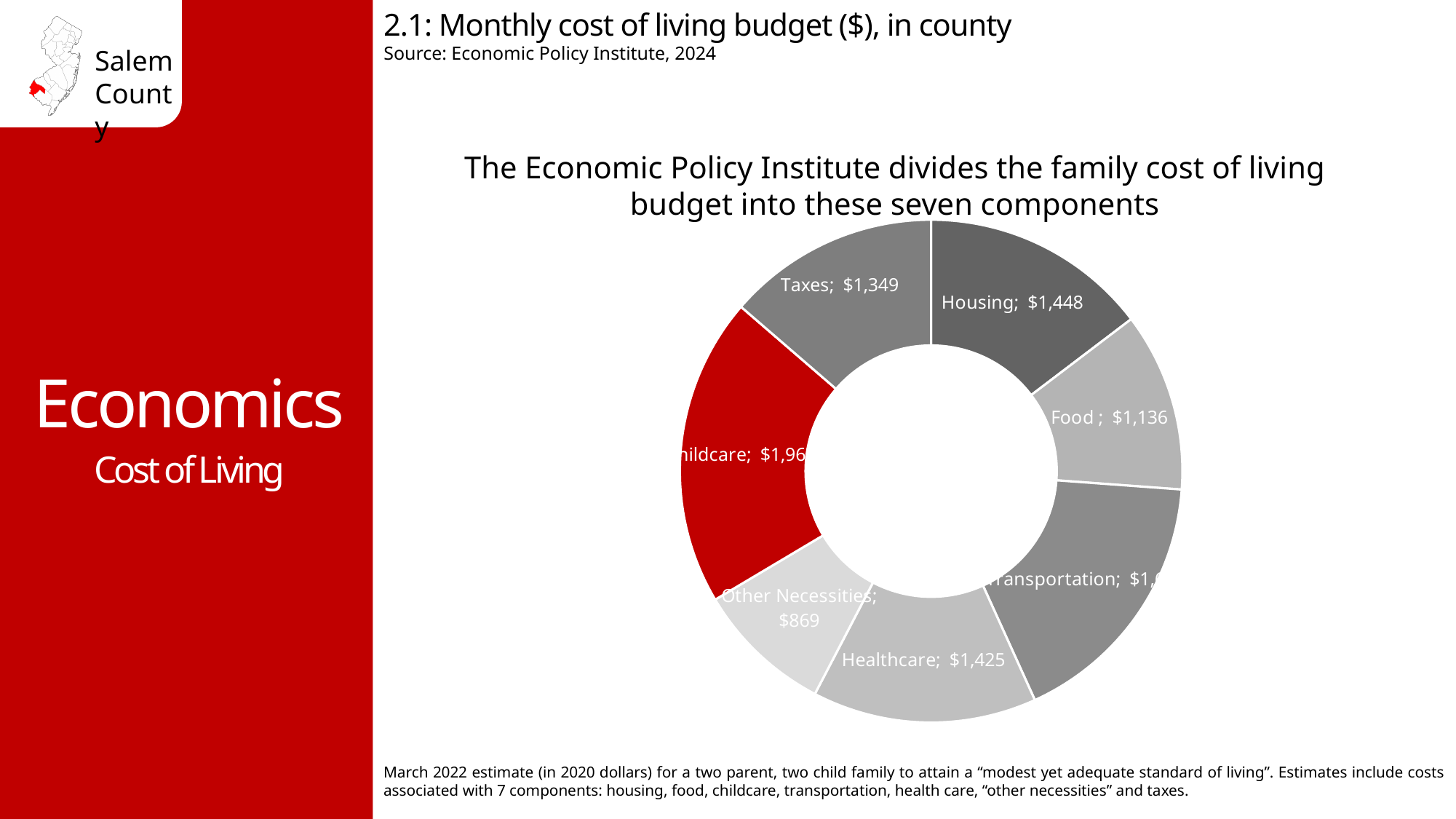
Which component has the smallest monthly cost? Other Necessities What kind of chart is shown on the slide? Doughnut (pie) chart Which is larger, the monthly cost for Healthcare or for Food? Healthcare What colour is the Childcare slice in the chart? Red What is the monthly cost for Healthcare? $1,425 What is the monthly cost for Housing? $1,448 What is the monthly cost for Other Necessities? $869 Which component has the largest monthly cost? Childcare What is the difference between the Housing and Taxes monthly costs? $99 What is the monthly cost for Food? $1,136 What is the monthly cost for Taxes? $1,349 How many components (slices) does the chart show? 7